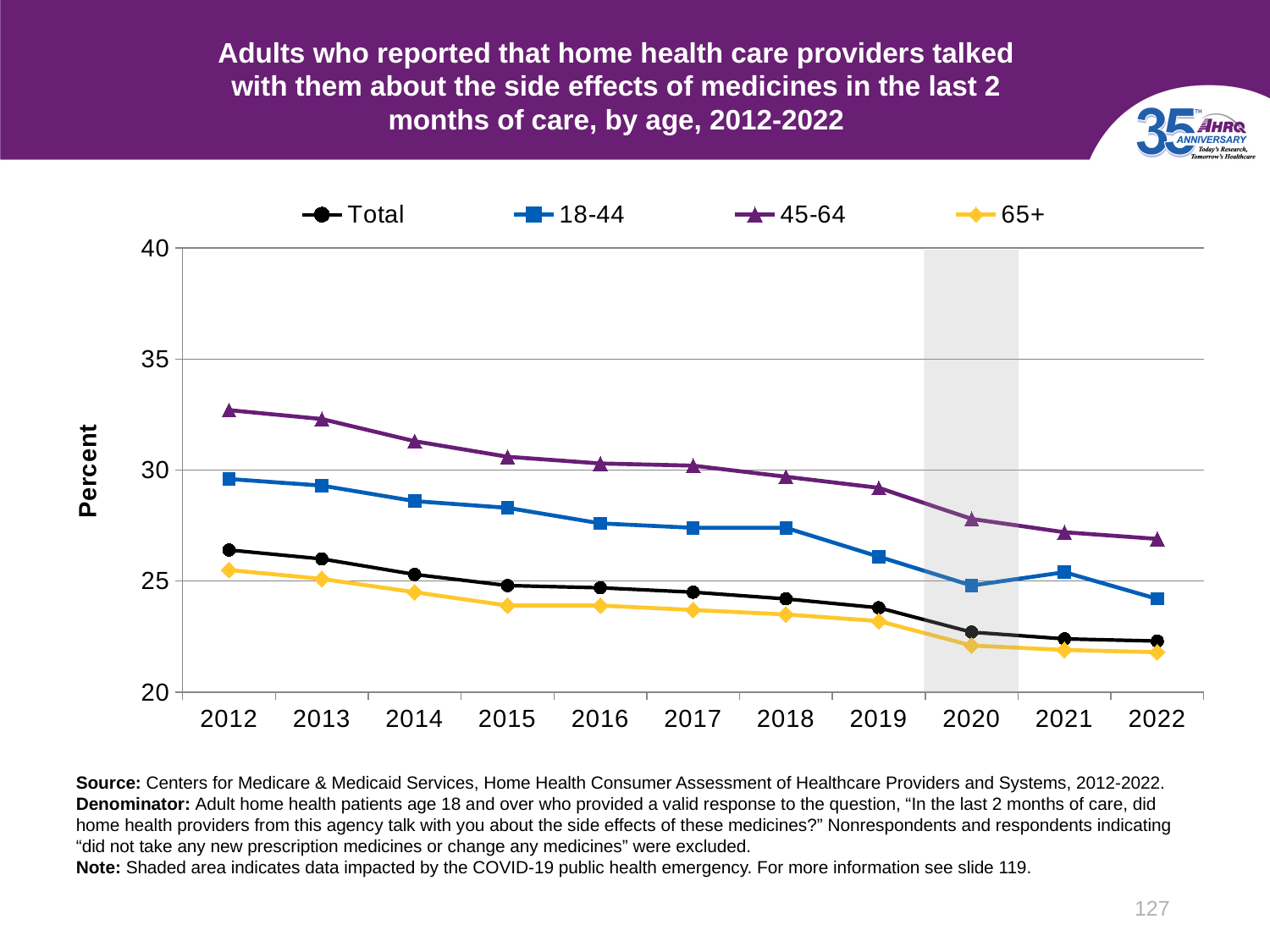
In 2018, which is larger: the value for the 18-44 group or the Total series? 18-44 Is the value for the 45-64 group in 2012 greater or less than 30? greater Which age group has the lowest value in 2022? 65+ Is the value for the Total series in 2020 greater or less than 25? less Which year is covered by the shaded area on the chart? 2020 How many years are plotted along the x axis? 11 How many series does the legend list? 4 What kind of chart is shown on the slide? line chart Is the value for the 18-44 group in 2016 greater or less than 25? greater Does the value for the 45-64 group rise or fall from 2012 to 2022? fall Which age group has the highest value in 2012? 45-64